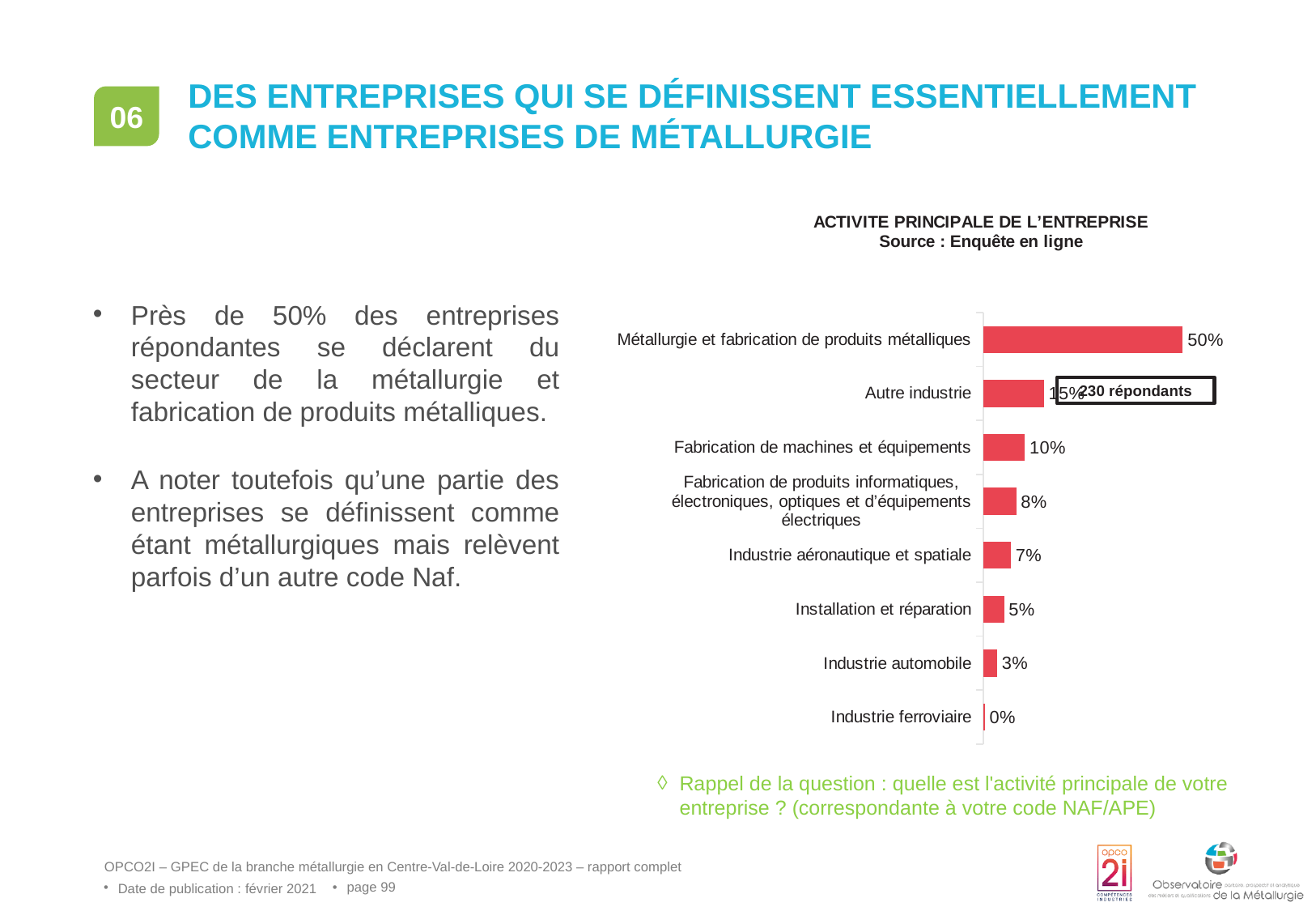
What is the difference between the values for Métallurgie et fabrication de produits métalliques and Fabrication de machines et équipements? 40 percentage points What kind of chart is shown on the slide? bar chart What is the value for Industrie aéronautique et spatiale? 7% What is the value for Industrie automobile? 3% Which category has the highest value? Métallurgie et fabrication de produits métalliques What is the value for Métallurgie et fabrication de produits métalliques? 50% Which is larger, the value for Installation et réparation or the value for Industrie automobile? Installation et réparation How many categories are shown in the chart? 8 Which category has the lowest value? Industrie ferroviaire What is the value for Fabrication de machines et équipements? 10% What is the title of the chart? ACTIVITE PRINCIPALE DE L'ENTREPRISE What is the value for Industrie ferroviaire? 0%